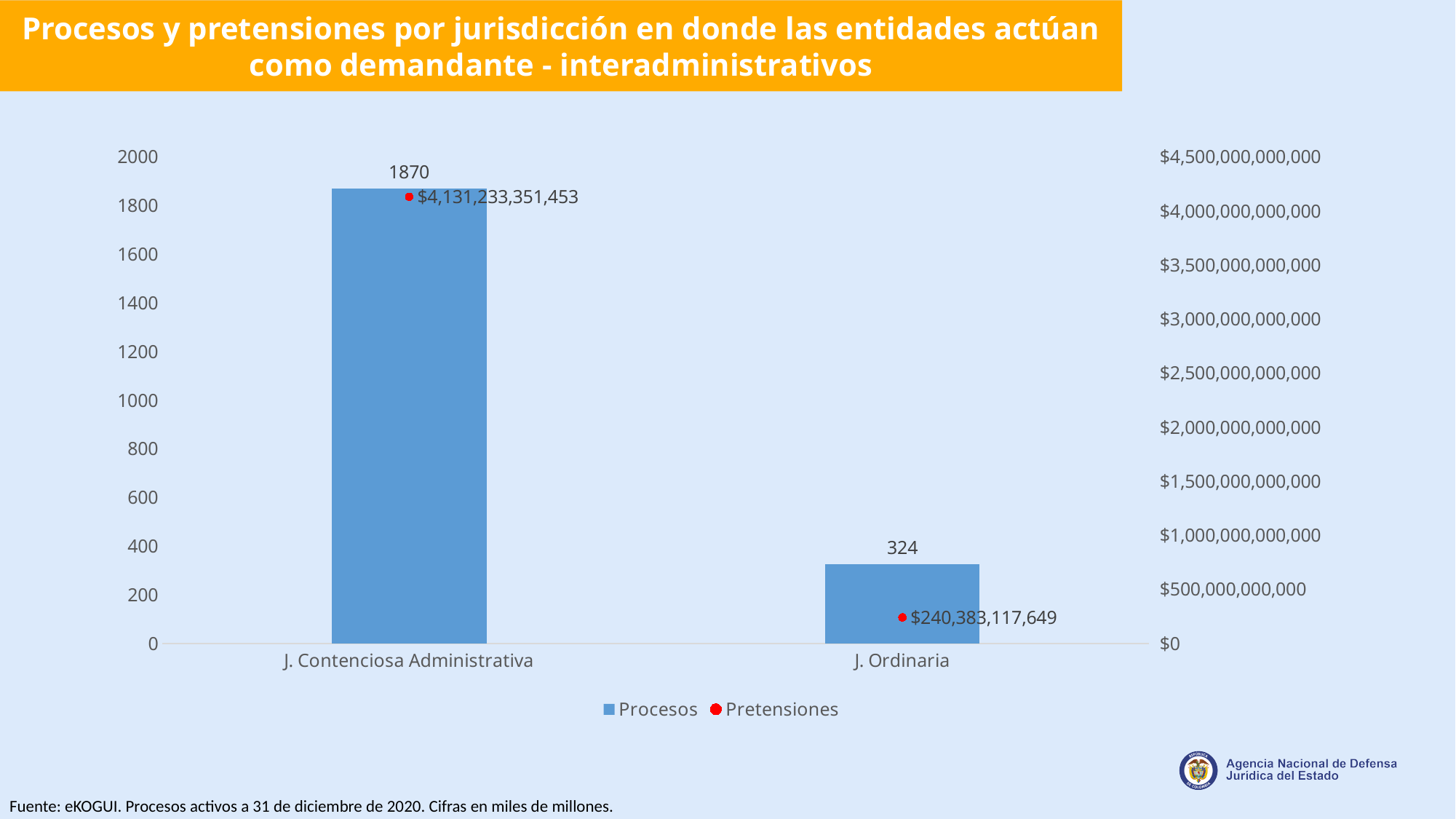
What is the Pretensiones value for J. Ordinaria? $240,383,117,649 What colour are the Procesos bars? Blue What is the Pretensiones value for J. Contenciosa Administrativa? $4,131,233,351,453 How many Procesos are shown for J. Contenciosa Administrativa? 1870 Which jurisdiction has the lowest Pretensiones value? J. Ordinaria What is the difference in Procesos between J. Contenciosa Administrativa and J. Ordinaria? 1546 Is the Procesos value for J. Ordinaria greater or less than 400? less How many series does the legend list? 2 How many jurisdictions are shown on the x axis? 2 Which has more Procesos, J. Contenciosa Administrativa or J. Ordinaria? J. Contenciosa Administrativa Which jurisdiction has the highest number of Procesos? J. Contenciosa Administrativa How many Procesos are shown for J. Ordinaria? 324